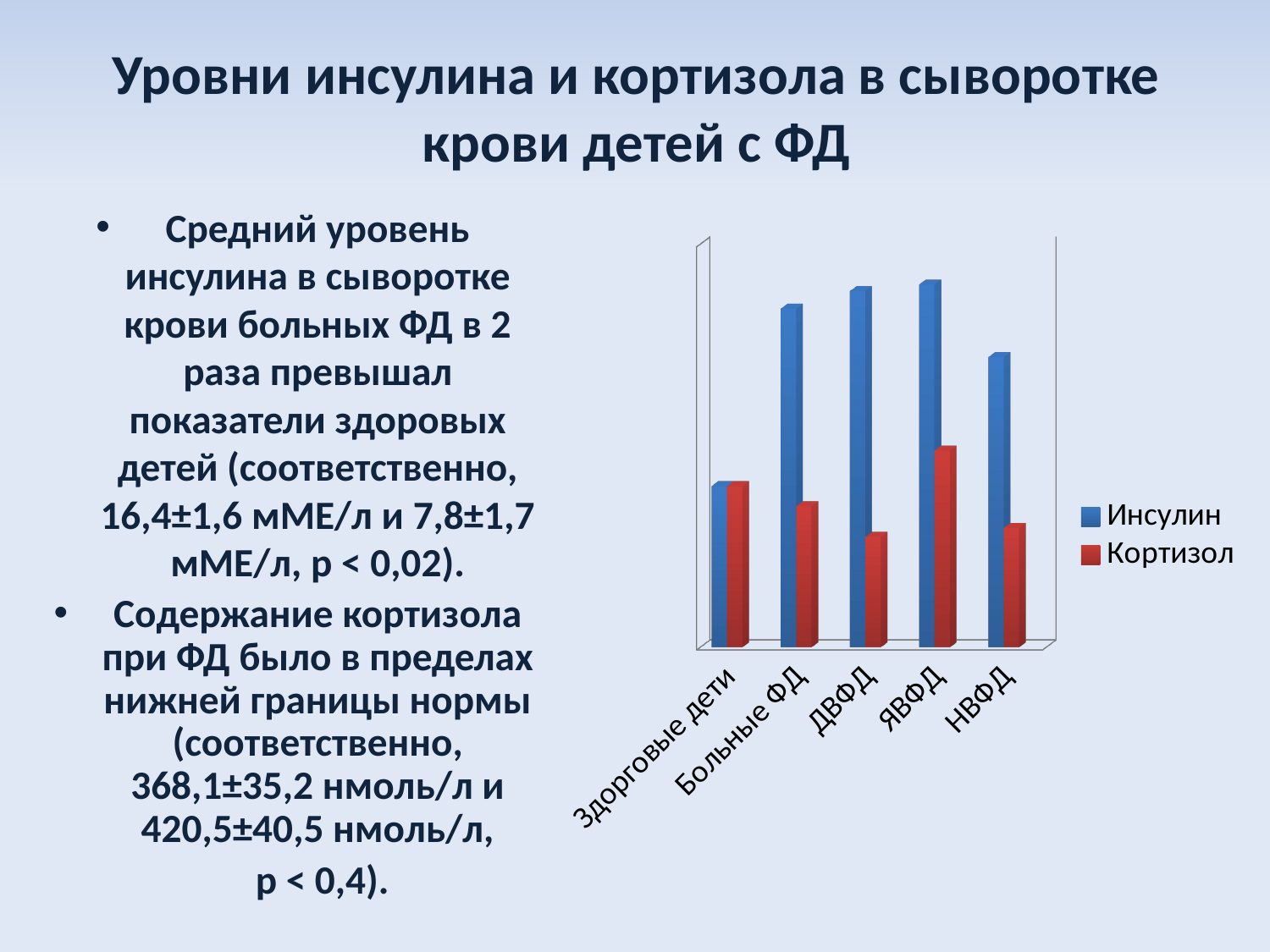
Which has the larger Инсулин value: Здорговые дети or ДВФД? ДВФД Which category has the lowest Инсулин value? Здорговые дети Which has the larger Кортизол value: Здорговые дети or ДВФД? Здорговые дети Which category has the highest Кортизол value? ЯВФД For the category Больные ФД, which is larger: the Инсулин value or the Кортизол value? Инсулин Which colour represents the Кортизол series in the chart? red What kind of chart is shown on the slide? bar chart Which two series are listed in the chart's legend? Инсулин and Кортизол How many series does the chart's legend list? 2 How many categories are shown on the x axis of the chart? 5